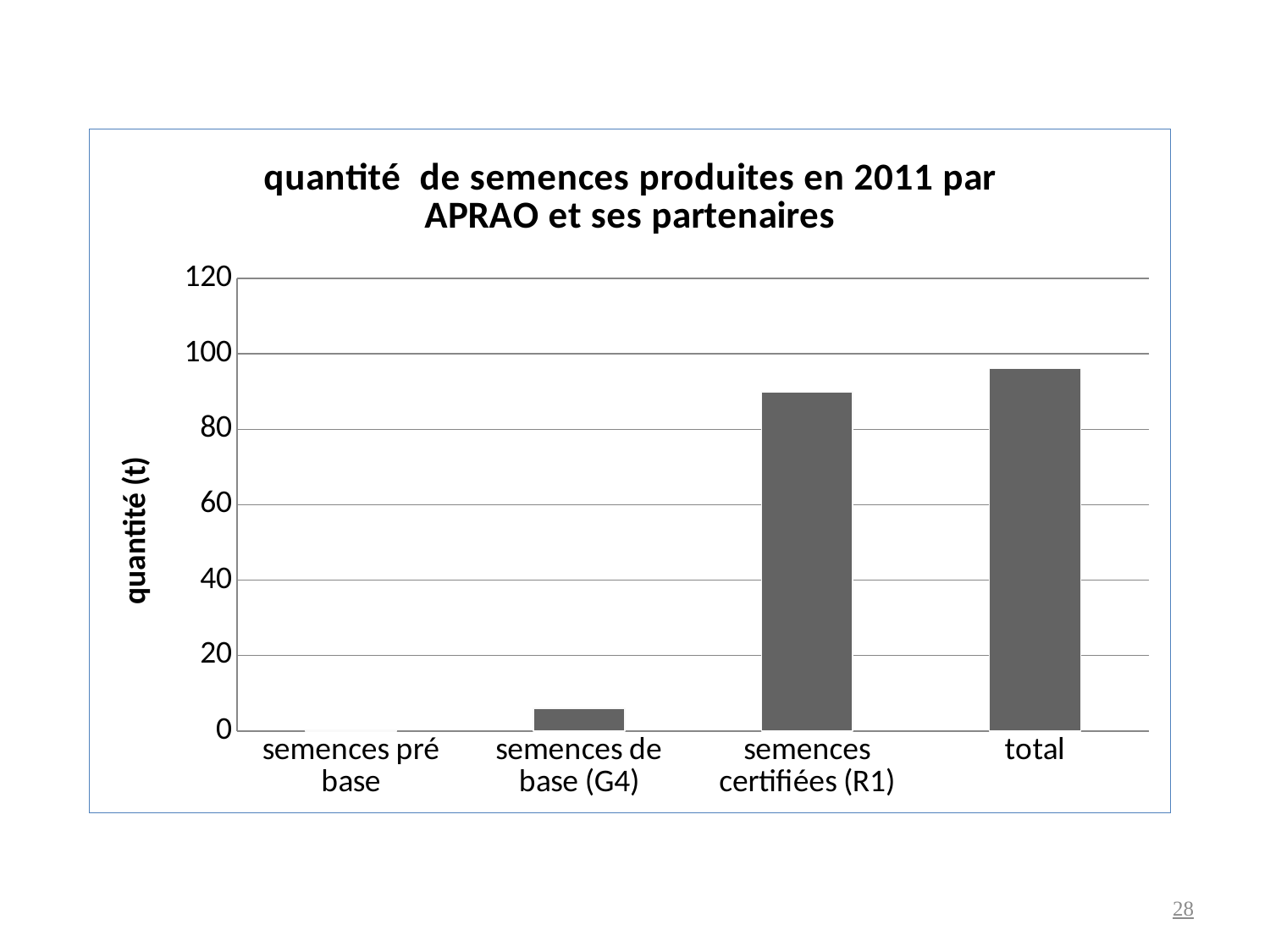
Which is larger, the value for semences certifiées (R1) or the value for semences de base (G4)? semences certifiées (R1) Which category has the highest value in the chart? total What is the label of the vertical axis of the chart? quantité (t) Do the bar values rise or fall from left to right along the x axis? rise Which is larger, the value for total or the value for semences certifiées (R1)? total Which category has the lowest value in the chart? semences pré base Is the value for total greater or less than 100? less What is the title of the chart? quantité de semences produites en 2011 par APRAO et ses partenaires How many categories are shown on the x axis of the chart? 4 Is the value for semences de base (G4) greater or less than 20? less Is the value for semences certifiées (R1) greater or less than 80? greater What kind of chart is shown on the slide? bar chart